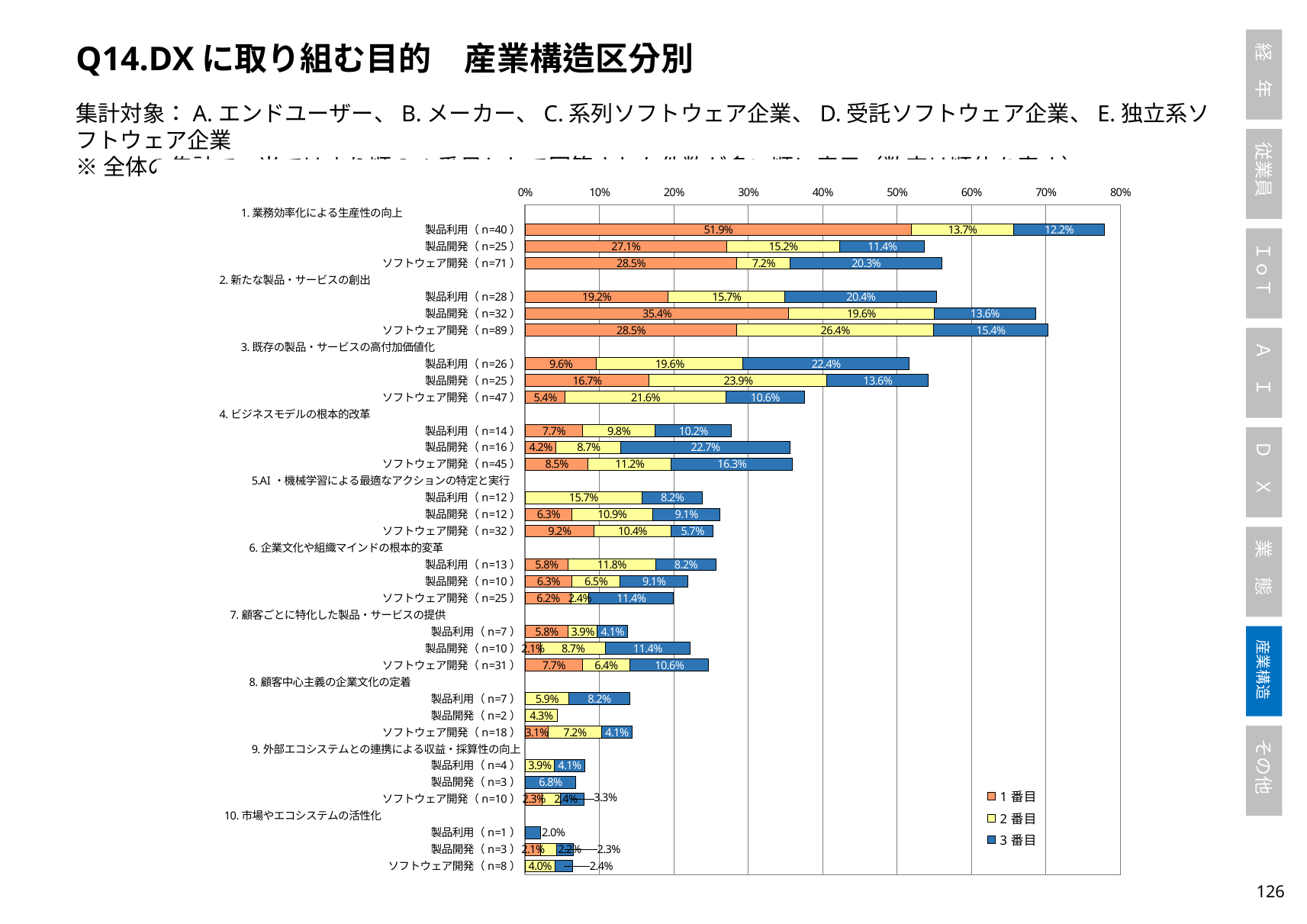
What is the 3番目 value for 製品開発（n=16） under 4. ビジネスモデルの根本的改革? 22.7% What is the 3番目 value for ソフトウェア開発（n=71） under 1. 業務効率化による生産性の向上? 20.3% What are the legend entries of the chart? 1番目, 2番目, 3番目 What is the total of the stacked bar for 製品利用（n=40） under 1. 業務効率化による生産性の向上? 77.8% Under 2. 新たな製品・サービスの創出, how much larger is the 1番目 value for 製品開発（n=32） than for 製品利用（n=28）? 16.2 percentage points Which bar has the largest 1番目 segment in the chart? 製品利用（n=40） under 1. 業務効率化による生産性の向上 What is the total of the stacked bar for ソフトウェア開発（n=89） under 2. 新たな製品・サービスの創出? 70.3% What kind of chart is shown on the slide? Stacked horizontal bar chart What is the 2番目 value for 製品開発（n=25） under 1. 業務効率化による生産性の向上? 15.2% What is the 1番目 value for 製品利用（n=40） under 1. 業務効率化による生産性の向上? 51.9% How many series does the legend list? 3 Under 3. 既存の製品・サービスの高付加価値化, which has the larger 2番目 value: 製品利用（n=26） or 製品開発（n=25）? 製品開発（n=25）